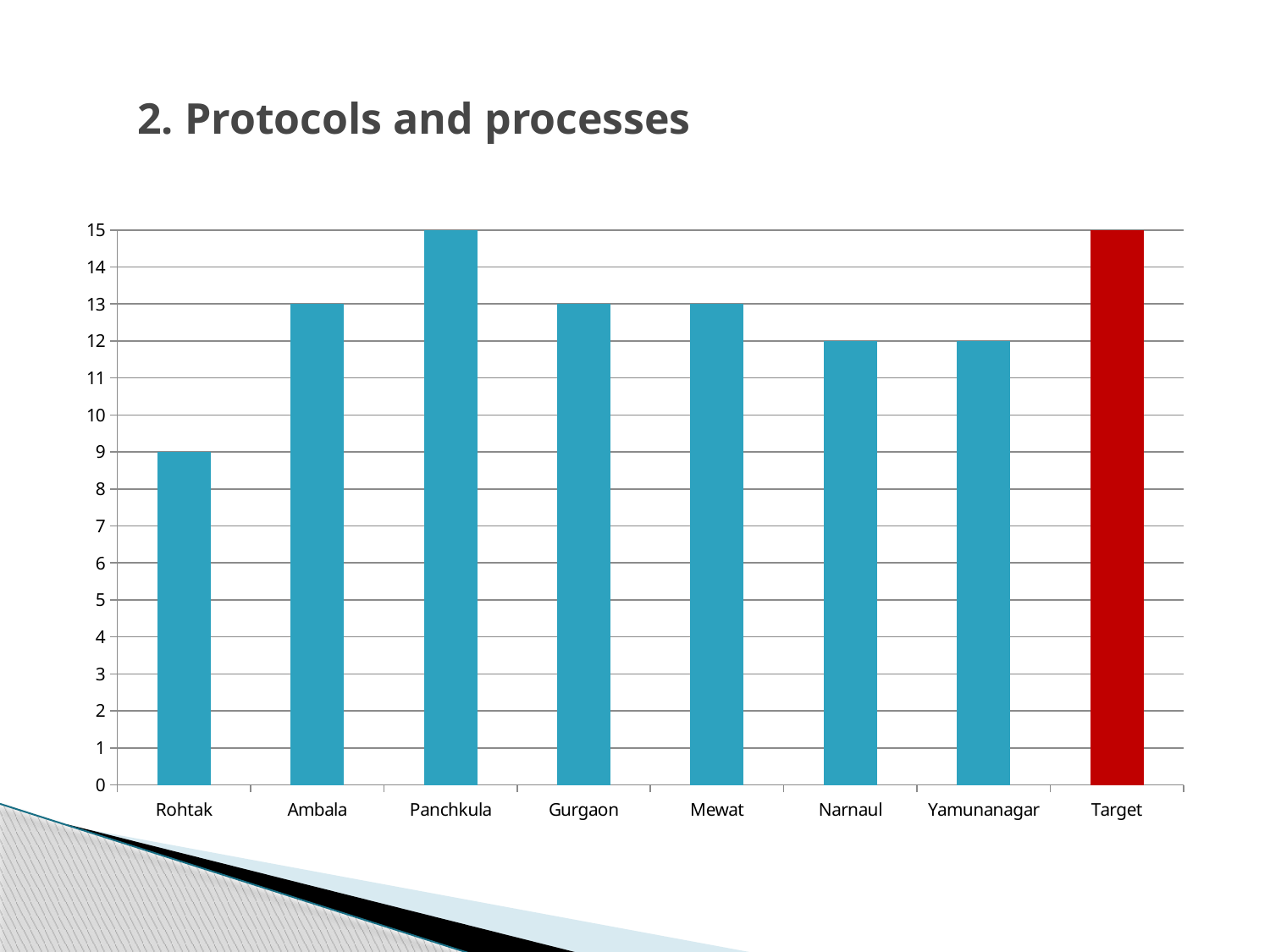
What is the difference between the values for Panchkula and Rohtak? 6 What is the value for Rohtak? 9 Which category has the lowest value? Rohtak What colour is the Target bar? red What is the value for Panchkula? 15 What is the value of the Target bar? 15 What is the value for Narnaul? 12 Which district, excluding the Target bar, has the highest value? Panchkula What kind of chart is shown on the slide? bar chart Is the value for Rohtak greater or less than 10? less How many bars are shown on the chart? 8 Which is larger, the value for Ambala or the value for Yamunanagar? Ambala